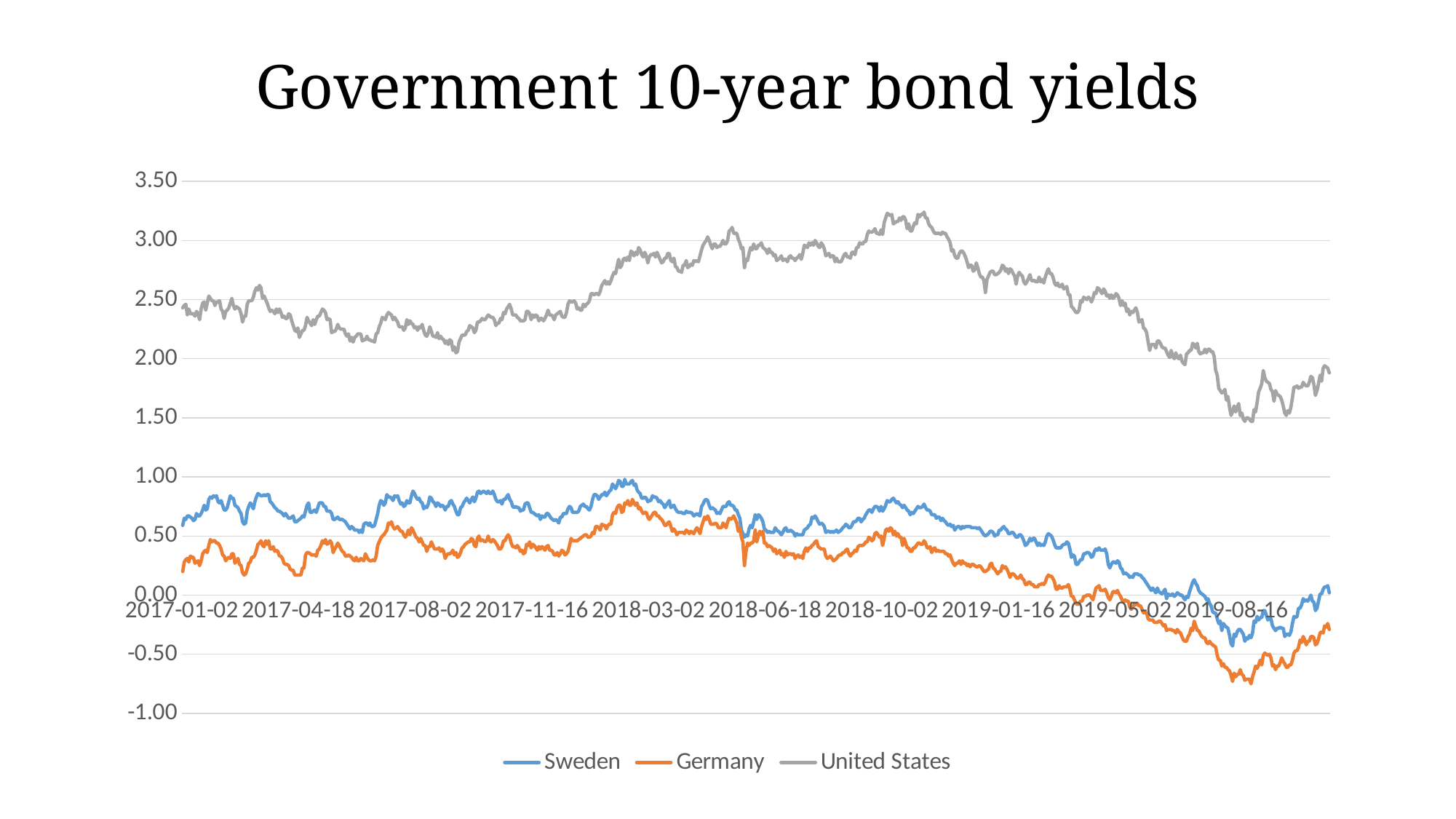
Is the value for Germany at 2017-01-02 greater or less than 0.50? less Does the United States yield rise or fall between 2019-01-16 and 2019-08-16? Fall Is the value for Sweden at 2018-03-02 greater or less than 0.50? greater Which series is drawn in grey? United States Which series has the lowest yield at the right end of the chart? Germany At 2018-10-02, which is larger, the Sweden yield or the Germany yield? Sweden What is the title of the chart? Government 10-year bond yields Is the value for Germany at 2019-08-16 greater or less than -0.50? less How many series does the legend list? 3 What kind of chart is shown on the slide? Line chart Which series has the highest yield across the whole period? United States